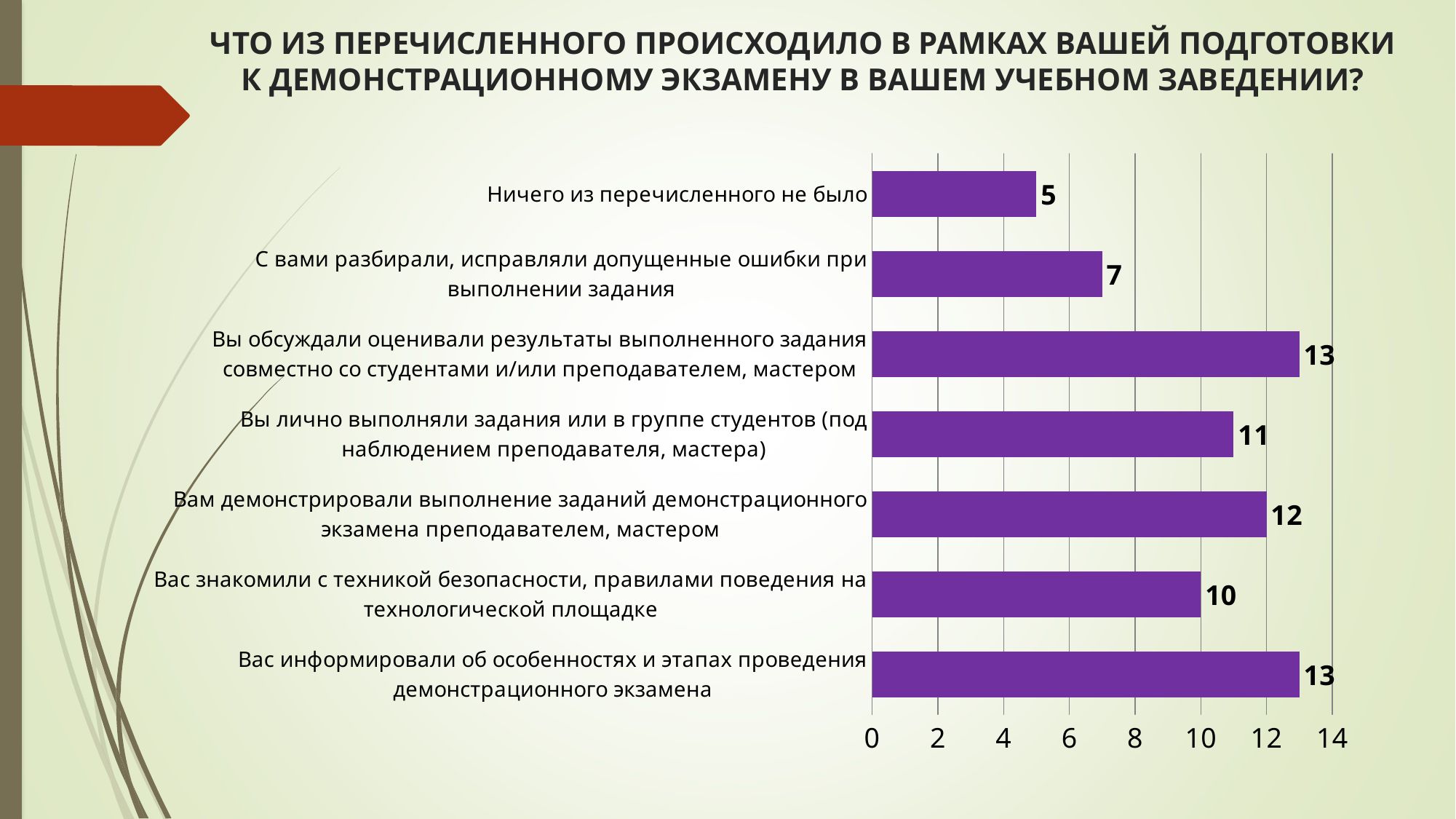
How many categories are shown on the chart? 7 What value is shown for "Вас знакомили с техникой безопасности, правилами поведения на технологической площадке"? 10 Which category has the lowest value? Ничего из перечисленного не было What value is shown for "Ничего из перечисленного не было"? 5 What is the maximum value shown on the horizontal axis? 14 Which is larger: the value for "Вам демонстрировали выполнение заданий демонстрационного экзамена преподавателем, мастером" or the value for "Вас знакомили с техникой безопасности, правилами поведения на технологической площадке"? Вам демонстрировали выполнение заданий демонстрационного экзамена преподавателем, мастером What is the highest value shown on the chart? 13 What value is shown for "Вам демонстрировали выполнение заданий демонстрационного экзамена преподавателем, мастером"? 12 What is the difference between the value for "Вы обсуждали оценивали результаты выполненного задания совместно со студентами и/или преподавателем, мастером" and the value for "С вами разбирали, исправляли допущенные ошибки при выполнении задания"? 6 What kind of chart is shown on the slide? bar chart Is the value for "С вами разбирали, исправляли допущенные ошибки при выполнении задания" greater or less than 8? less What value is shown for "Вы лично выполняли задания или в группе студентов (под наблюдением преподавателя, мастера)"? 11